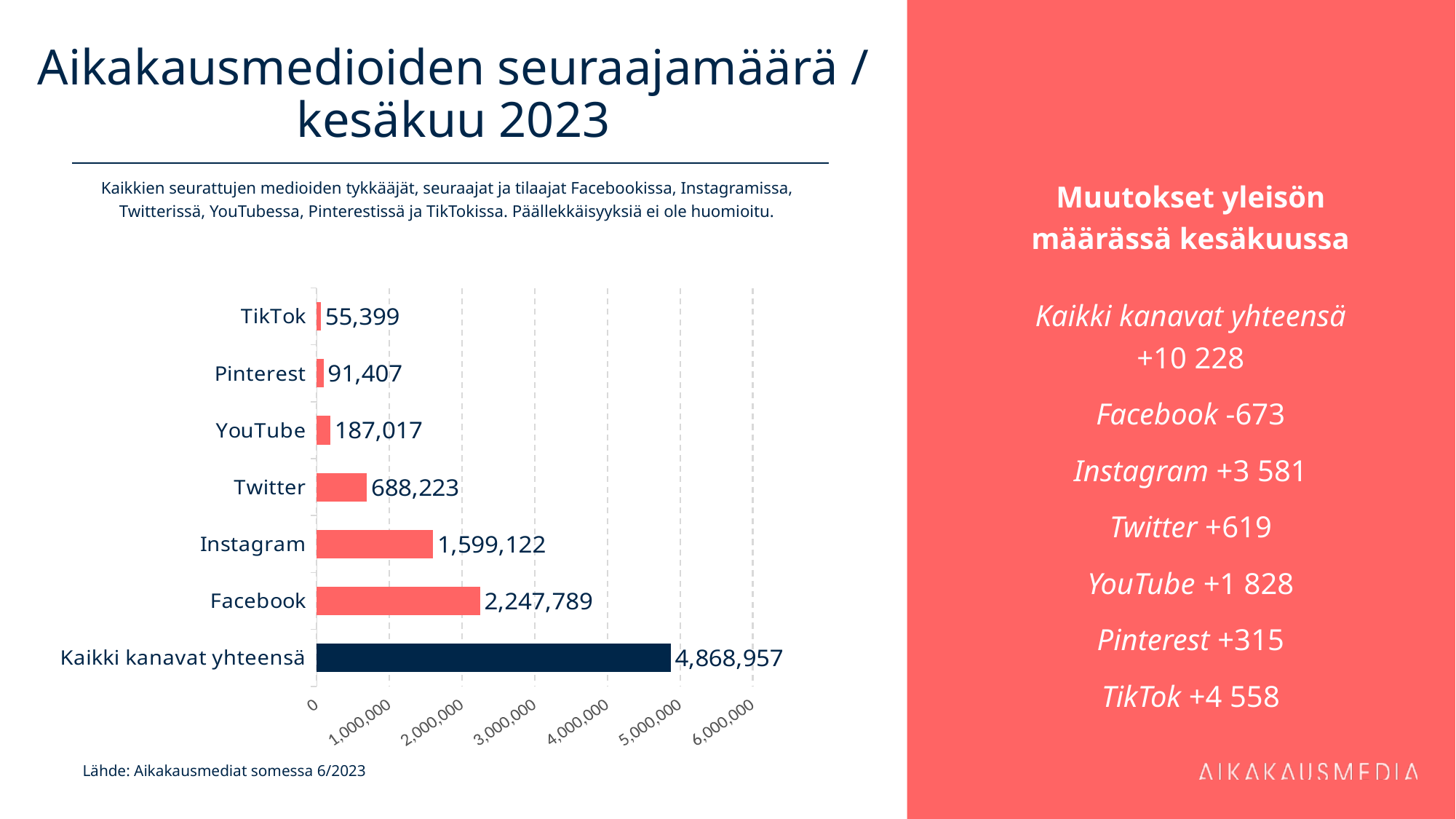
Which category has the highest value in the chart? Kaikki kanavat yhteensä How many bars are shown in the chart? 7 What is the value shown for Instagram? 1,599,122 What is the difference between the values for Facebook and Instagram? 648,667 What is the difference between the values for Twitter and YouTube? 501,206 What is the value shown for Kaikki kanavat yhteensä? 4,868,957 What is the value shown for TikTok? 55,399 What kind of chart is shown on the slide? bar chart What is the value shown for Facebook? 2,247,789 Which has a larger value, Pinterest or YouTube? YouTube Is the value for Facebook greater or less than 2,000,000? greater Which category has the lowest value in the chart? TikTok